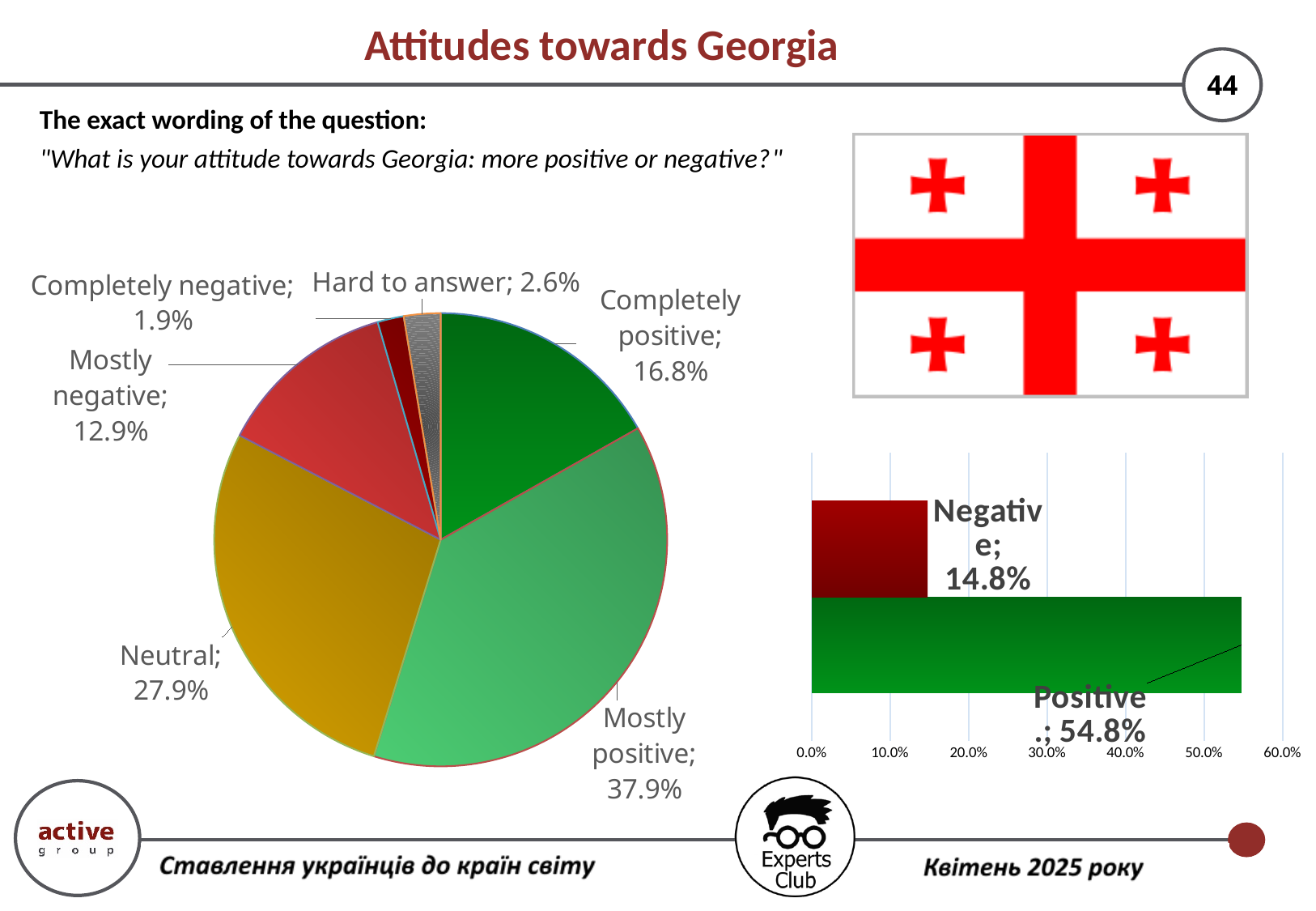
In the pie chart on the left, what is the difference between the "Mostly positive" and "Completely positive" shares? 21.1% In the bar chart on the right, what is the value for "Negative"? 14.8% In the pie chart on the left, which is larger: "Neutral" or "Mostly negative"? Neutral What kind of chart is the chart on the left of the slide? Pie chart In the pie chart on the left, what share of respondents answered "Neutral"? 27.9% In the bar chart on the right, what is the value for "Positive"? 54.8% In the pie chart on the left, what share of respondents answered "Hard to answer"? 2.6% In the pie chart on the left, which category has the largest share? Mostly positive In the pie chart on the left, what share of respondents answered "Mostly positive"? 37.9% In the pie chart on the left, which category has the smallest share? Completely negative How many categories does the pie chart on the left show? 6 In the bar chart on the right, what is the difference between the "Positive" and "Negative" values? 40.0%